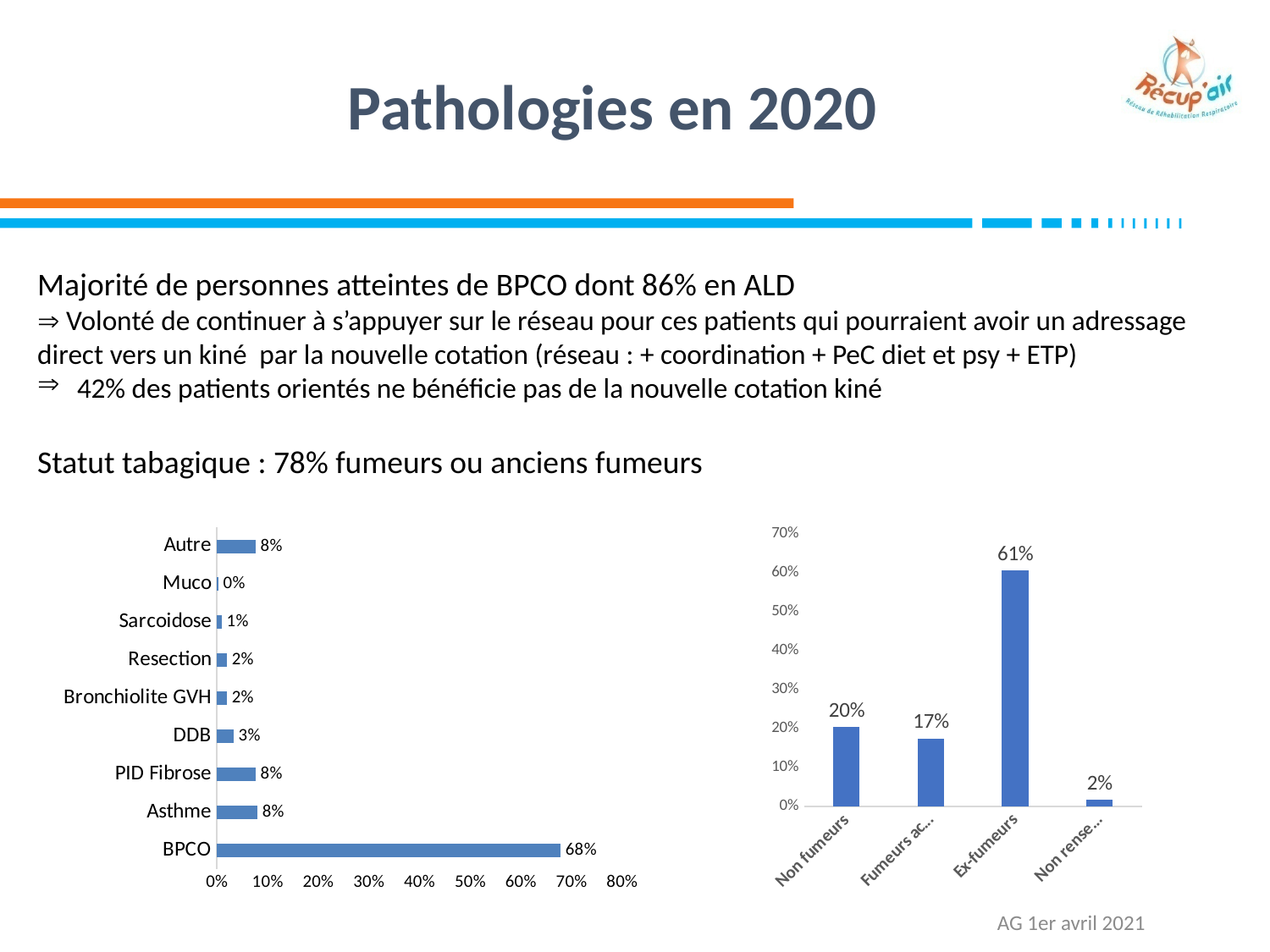
In the left chart (pathologies), which category has the highest value? BPCO In the left chart (pathologies), which category has the lowest value? Muco In the left chart (pathologies), what is the value for BPCO? 68% What kind of chart is the left chart (pathologies)? Bar chart In the left chart (pathologies), what is the difference between the values for BPCO and Asthme? 60% In the left chart (pathologies), how many categories are shown? 9 In the right chart (smoking status), how many bars are shown? 4 In the right chart (smoking status), what is the value for Non fumeurs? 20% In the left chart (pathologies), which is larger, the value for DDB or the value for Sarcoidose? DDB In the right chart (smoking status), what is the value for Ex-fumeurs? 61% In the left chart (pathologies), what is the value for DDB? 3% In the right chart (smoking status), which category has the highest value? Ex-fumeurs